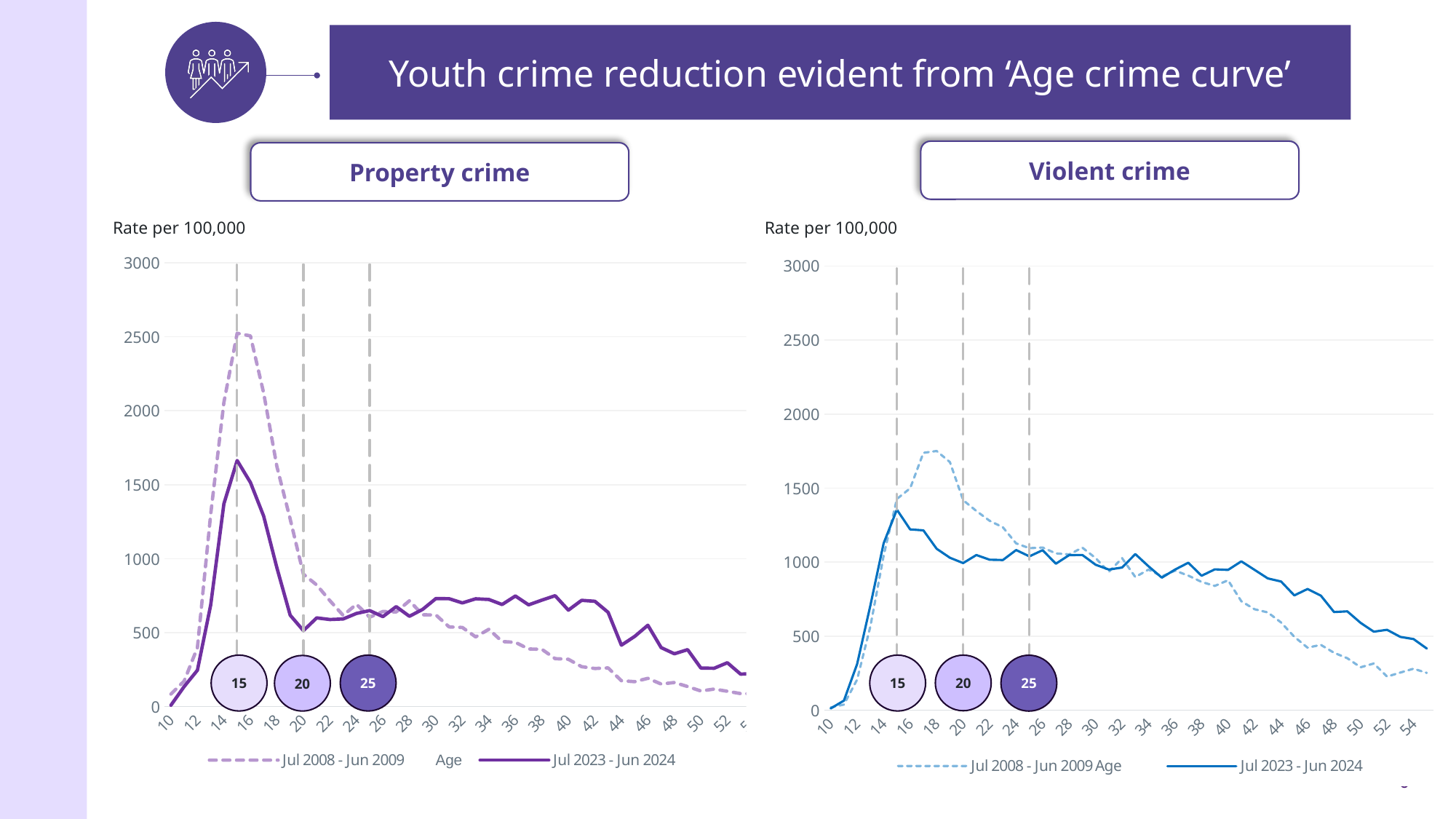
In the Property crime chart, which series has the higher value at age 15, Jul 2008 - Jun 2009 or Jul 2023 - Jun 2024? Jul 2008 - Jun 2009 In the Property crime chart, is the value for Jul 2008 - Jun 2009 at age 15 greater or less than 2000? greater In the Violent crime chart, is the value for Jul 2008 - Jun 2009 at age 18 greater or less than 1500? greater How many series does the legend of the Violent crime chart list? 2 In the Violent crime chart, which series has the higher value at age 18, Jul 2008 - Jun 2009 or Jul 2023 - Jun 2024? Jul 2008 - Jun 2009 In the Property crime chart, do the Jul 2008 - Jun 2009 values rise or fall from age 16 to age 54? fall In the Violent crime chart, do the Jul 2023 - Jun 2024 values rise or fall from age 34 to age 54? fall In the Violent crime chart, is the value for Jul 2023 - Jun 2024 at age 15 greater or less than 1500? less What is the title of the slide containing the two charts? Youth crime reduction evident from 'Age crime curve' What kind of chart is the Property crime chart? line chart What is the y-axis label on the Violent crime chart? Rate per 100,000